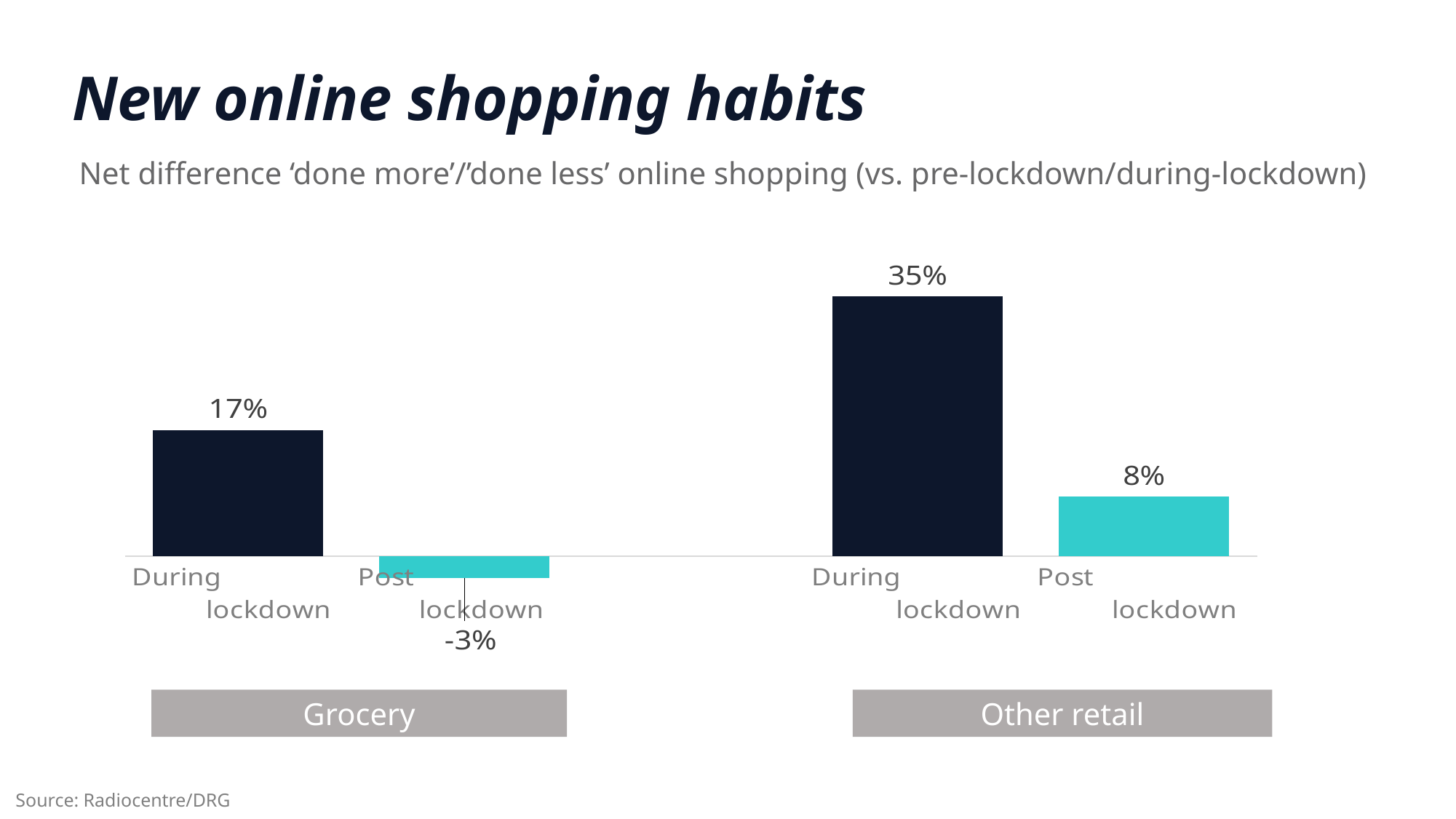
What is the difference between the Other retail during-lockdown value and the Grocery during-lockdown value? 18 percentage points What is the net difference for Other retail during lockdown? 35% What is the net difference for Grocery post lockdown? -3% Which bar has the lowest value? Grocery, Post lockdown What is the net difference for Grocery during lockdown? 17% How many bars are plotted on the chart? 4 What is the source cited for the chart? Radiocentre/DRG Which bar has the highest value? Other retail, During lockdown What is the difference between the Other retail post-lockdown value and the Grocery post-lockdown value? 11 percentage points Which is larger: the Grocery during-lockdown value or the Other retail post-lockdown value? Grocery during lockdown What kind of chart is shown on the slide? Bar chart What is the net difference for Other retail post lockdown? 8%